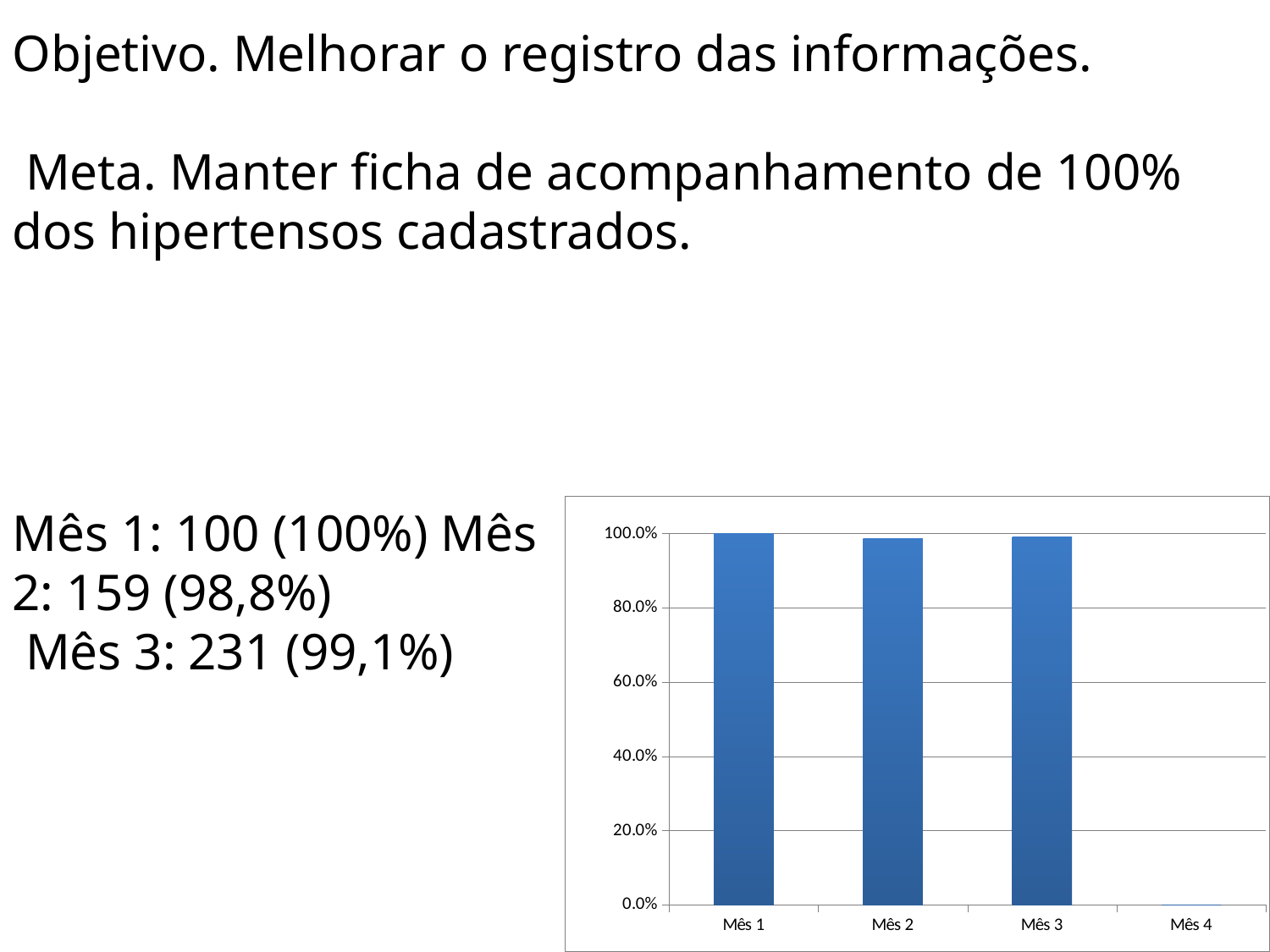
What is the lowest tick value shown on the y axis? 0.0% Is the value for Mês 1 greater or less than 40.0%? greater Which is larger, the value for Mês 1 or the value for Mês 4? Mês 1 What is the highest tick value shown on the y axis? 100.0% Is the value for Mês 3 greater or less than 60.0%? greater Which category on the x axis has no bar plotted? Mês 4 How many categories are shown on the x axis of the chart? 4 Is the value for Mês 2 greater or less than 80.0%? greater What kind of chart is shown on the slide? bar chart What is the value of the bar for Mês 1? 100.0%